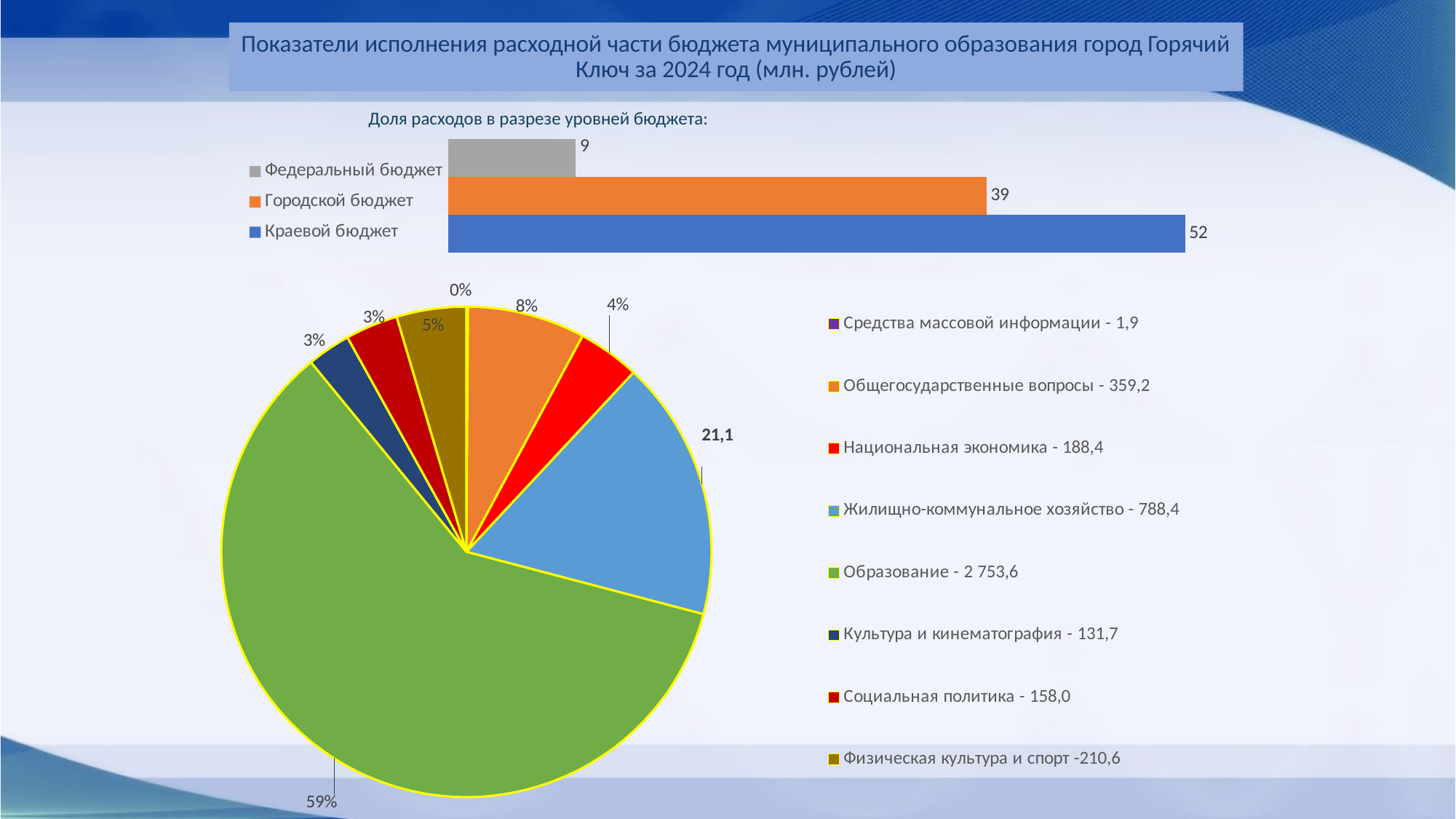
In the pie chart legend, what value is given for Образование? 2 753,6 In the pie chart, what share does Общегосударственные вопросы account for? 8% In the bar chart 'Доля расходов в разрезе уровней бюджета', what is the value for Городской бюджет? 39 In the pie chart, what share of expenditure does Образование account for? 59% In the bar chart 'Доля расходов в разрезе уровней бюджета', what is the difference between Краевой бюджет and Городской бюджет? 13 In the bar chart 'Доля расходов в разрезе уровней бюджета', which budget level has the lowest value? Федеральный бюджет How many entries does the pie chart legend list? 8 In the bar chart 'Доля расходов в разрезе уровней бюджета', how many budget levels are shown? 3 In the pie chart legend, what value is given for Жилищно-коммунальное хозяйство? 788,4 In the bar chart 'Доля расходов в разрезе уровней бюджета', what is the value for Краевой бюджет? 52 In the bar chart 'Доля расходов в разрезе уровней бюджета', which budget level has the highest value? Краевой бюджет What type of chart is the upper chart 'Доля расходов в разрезе уровней бюджета'? Bar chart